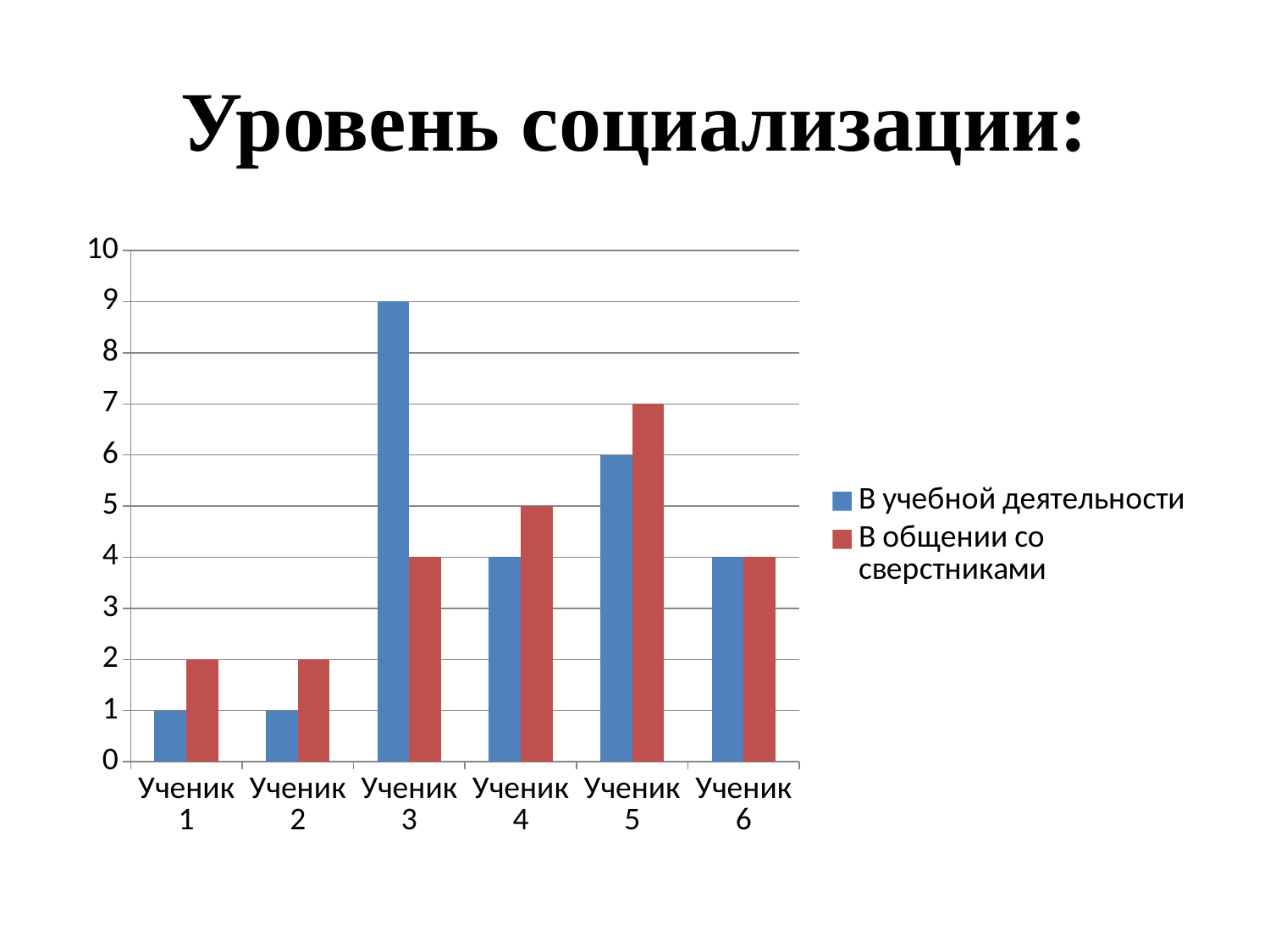
Is the value for Ученик 3 in the series 'В учебной деятельности' greater or less than 5? greater What is the title of the slide? Уровень социализации: How many series does the legend list? 2 What is the value for Ученик 5 in the series 'В общении со сверстниками'? 7 What type of chart is shown on the slide? bar chart What is the value for Ученик 3 in the series 'В учебной деятельности'? 9 What is the value for Ученик 1 in the series 'В учебной деятельности'? 1 For Ученик 4, which series has the larger value? В общении со сверстниками Which student has the highest value in the series 'В общении со сверстниками'? Ученик 5 What is the difference between the two series for Ученик 3? 5 How many categories (students) are shown on the x axis? 6 Which student has the highest value in the series 'В учебной деятельности'? Ученик 3